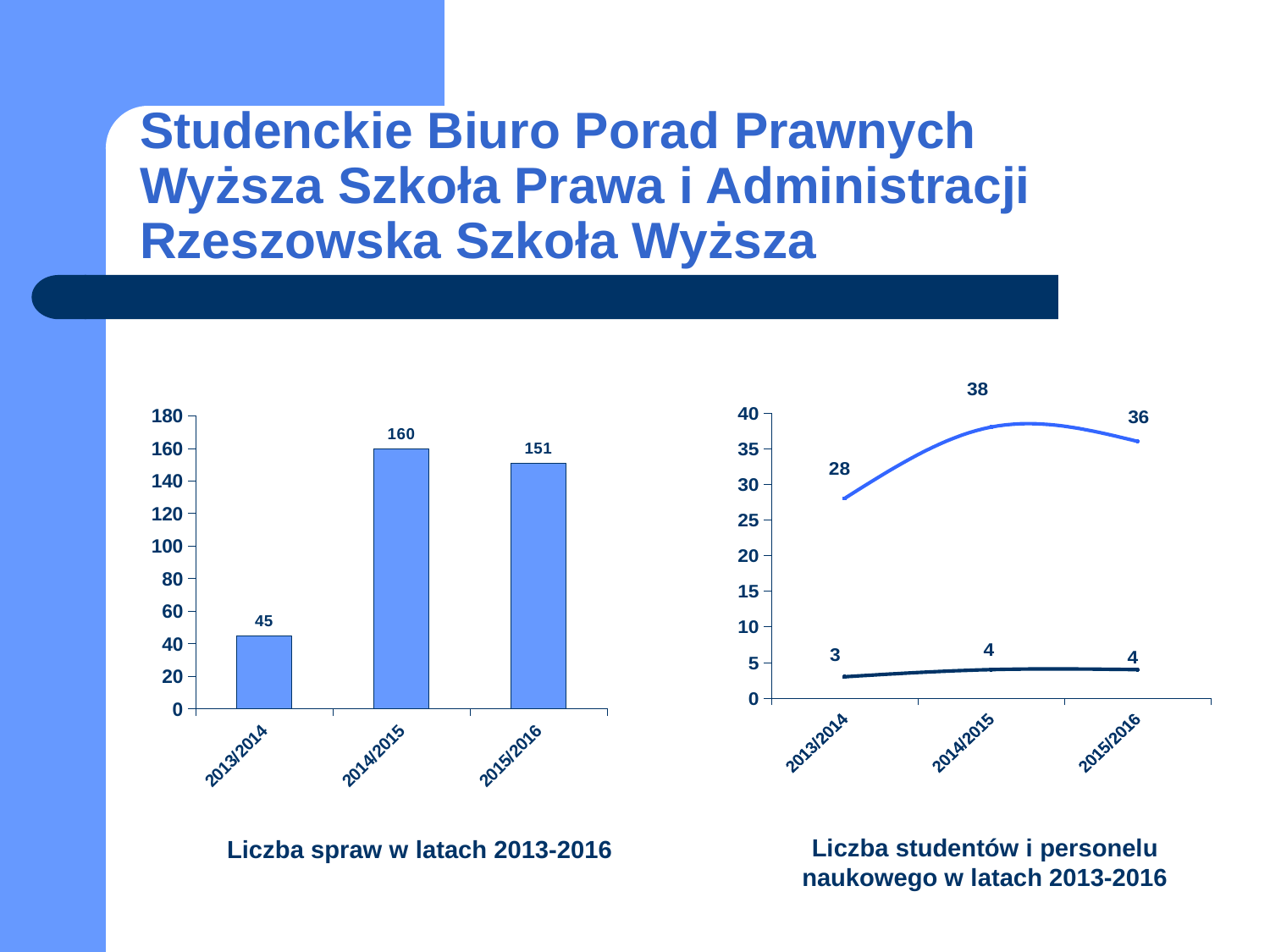
In the left chart (Liczba spraw w latach 2013-2016), which year has the lowest value? 2013/2014 What kind of chart is the right chart (Liczba studentów i personelu naukowego w latach 2013-2016)? line chart In the right chart (Liczba studentów i personelu naukowego w latach 2013-2016), is the upper line's value for 2013/2014 larger or smaller than its value for 2015/2016? smaller What kind of chart is the left chart (Liczba spraw w latach 2013-2016)? bar chart In the left chart (Liczba spraw w latach 2013-2016), which year has the highest value? 2014/2015 In the left chart (Liczba spraw w latach 2013-2016), what is the value for 2013/2014? 45 In the right chart (Liczba studentów i personelu naukowego w latach 2013-2016), what is the value of the upper line for 2014/2015? 38 In the right chart (Liczba studentów i personelu naukowego w latach 2013-2016), what is the difference between the upper line's values for 2013/2014 and 2014/2015? 10 In the left chart (Liczba spraw w latach 2013-2016), what is the difference between the values for 2014/2015 and 2015/2016? 9 In the left chart (Liczba spraw w latach 2013-2016), what is the value for 2014/2015? 160 In the right chart (Liczba studentów i personelu naukowego w latach 2013-2016), what is the value of the lower line for 2013/2014? 3 In the left chart (Liczba spraw w latach 2013-2016), how many categories are shown on the x axis? 3